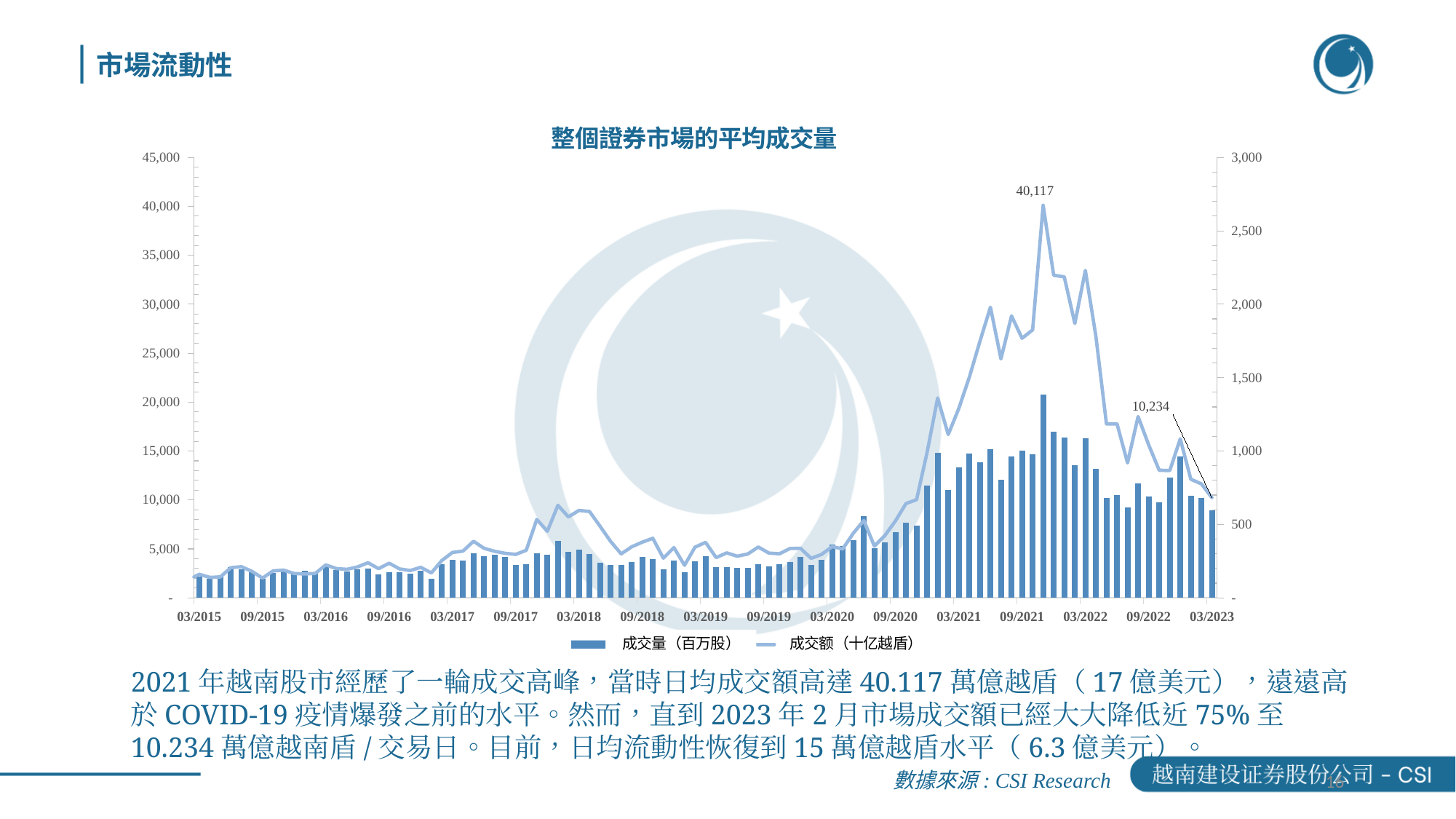
Is the value of the 成交額 line at 03/2015 greater or less than 5,000 on the left axis? less Which is larger, the 成交額 line value at 09/2021 or at 03/2016? 09/2021 Does the 成交額 line rise or fall from its peak of 40,117 to the labeled value of 10,234? fall What kind of chart is shown on the slide? Combination bar and line chart What is the title of the chart? 整個證券市場的平均成交量 Does the 成交額 line rise or fall between 03/2015 and its peak in late 2021? rise What value is labeled on the 成交額 line near the end of the series, close to 03/2023? 10,234 Is the value of the 成交額 line at 09/2021 greater or less than 20,000 on the left axis? greater What is the difference between the labeled peak value 40,117 and the later labeled value 10,234? 29,883 Which series is drawn as a line in the chart? 成交額（十億越盾） What is the peak value labeled on the 成交額 line? 40,117 How many series does the chart legend list? 2